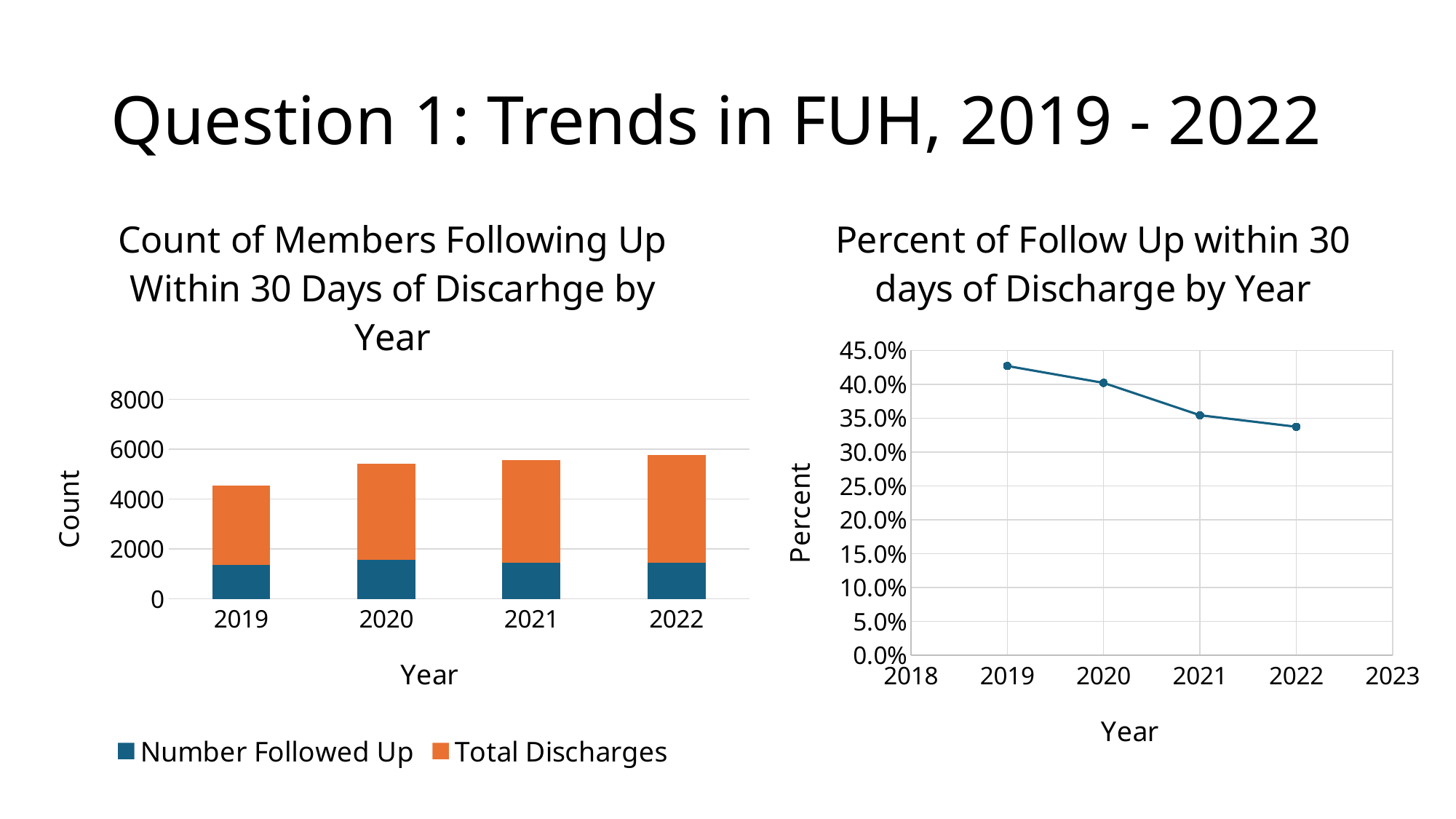
In the left chart, is the Number Followed Up value for 2019 greater or less than 2000? less In the left chart, which year has the lowest total bar? 2019 In the right chart, which year has the highest percent? 2019 In the left chart, how many years are shown on the x axis? 4 In the left chart, is the total height of the 2022 bar greater or less than 4000? greater In the left chart, is the total height of the 2019 bar greater or less than 6000? less In the right chart, do the values rise or fall from 2019 to 2022? fall What kind of chart is the chart on the left, titled "Count of Members Following Up Within 30 Days of Discarhge by Year"? Stacked bar chart In the left chart, how many series does the legend list? 2 What kind of chart is the chart on the right, titled "Percent of Follow Up within 30 days of Discharge by Year"? Line chart